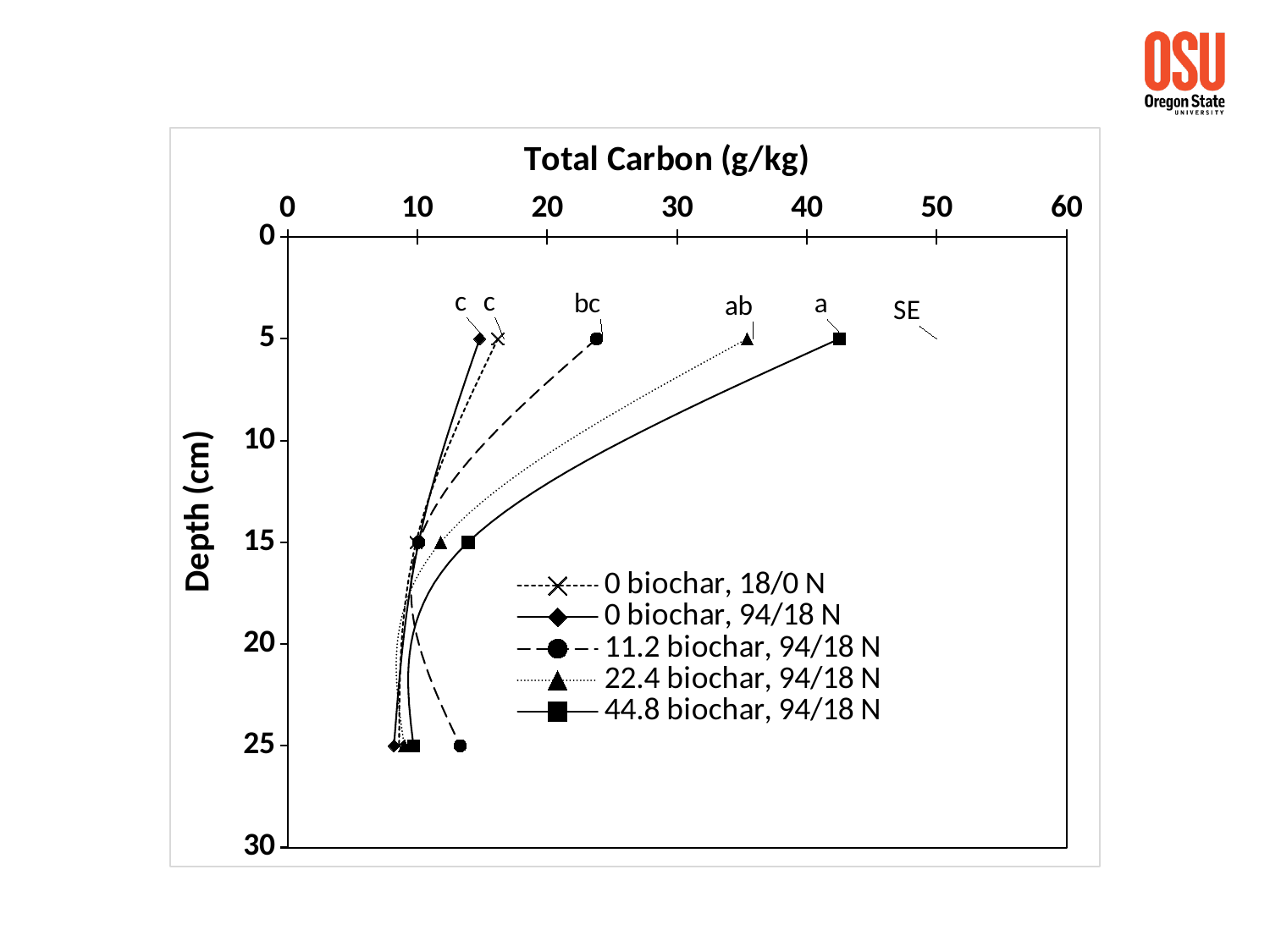
Is the total carbon for 22.4 biochar, 94/18 N at 5 cm depth greater or less than 30? greater Is the total carbon for 44.8 biochar, 94/18 N at 5 cm depth greater or less than 40? greater At a depth of 25 cm, which series has the highest total carbon? 11.2 biochar, 94/18 N At a depth of 5 cm, which series has the highest total carbon? 44.8 biochar, 94/18 N How many depth points are plotted for each series? 3 What is the title shown above the chart? Total Carbon (g/kg) Is the total carbon for 0 biochar, 94/18 N at 5 cm depth greater or less than 20? less At 5 cm depth, which has the larger total carbon: 22.4 biochar, 94/18 N or 11.2 biochar, 94/18 N? 22.4 biochar, 94/18 N How many series does the legend list? 5 What kind of chart is shown on the slide? line chart For the 44.8 biochar, 94/18 N series, does total carbon increase or decrease as depth increases from 5 cm to 25 cm? decrease What is the label of the vertical axis? Depth (cm)